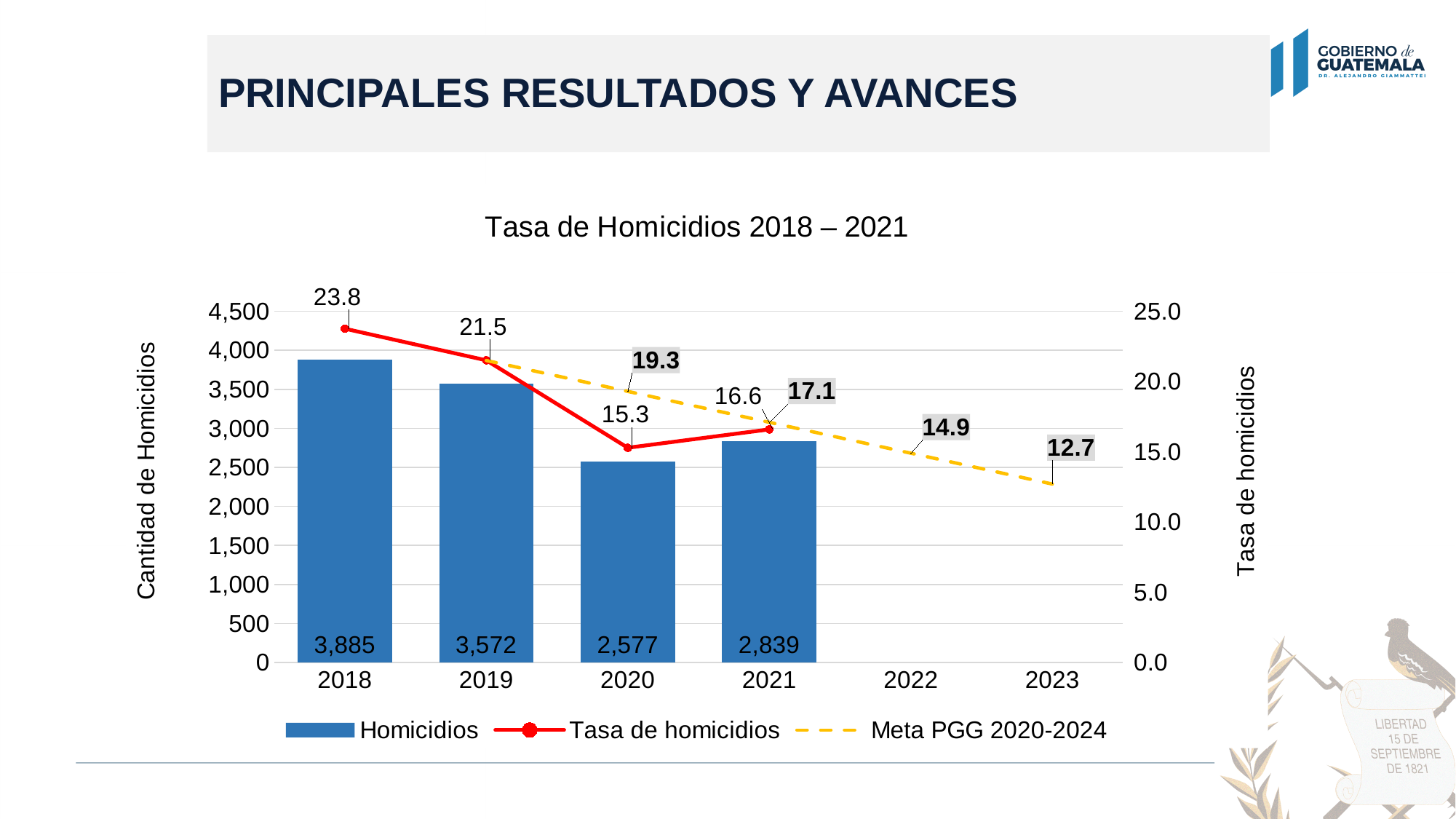
Does the Meta PGG 2020-2024 line rise or fall from 2020 to 2023? Fall What is the title of the chart? Tasa de Homicidios 2018 – 2021 Which year has the highest Tasa de homicidios? 2018 How many years are shown on the x axis? 6 How many series does the legend list? 3 What kind of chart is this? Combined bar and line chart What is the Meta PGG 2020-2024 value for 2023? 12.7 What is the Tasa de homicidios value for 2020? 15.3 Which is larger: the Tasa de homicidios for 2021 or the Meta PGG 2020-2024 for 2021? Meta PGG 2020-2024 for 2021 What is the number of Homicidios for 2018? 3,885 Which year has the lowest number of Homicidios? 2020 What is the difference in Homicidios between 2018 and 2021? 1,046